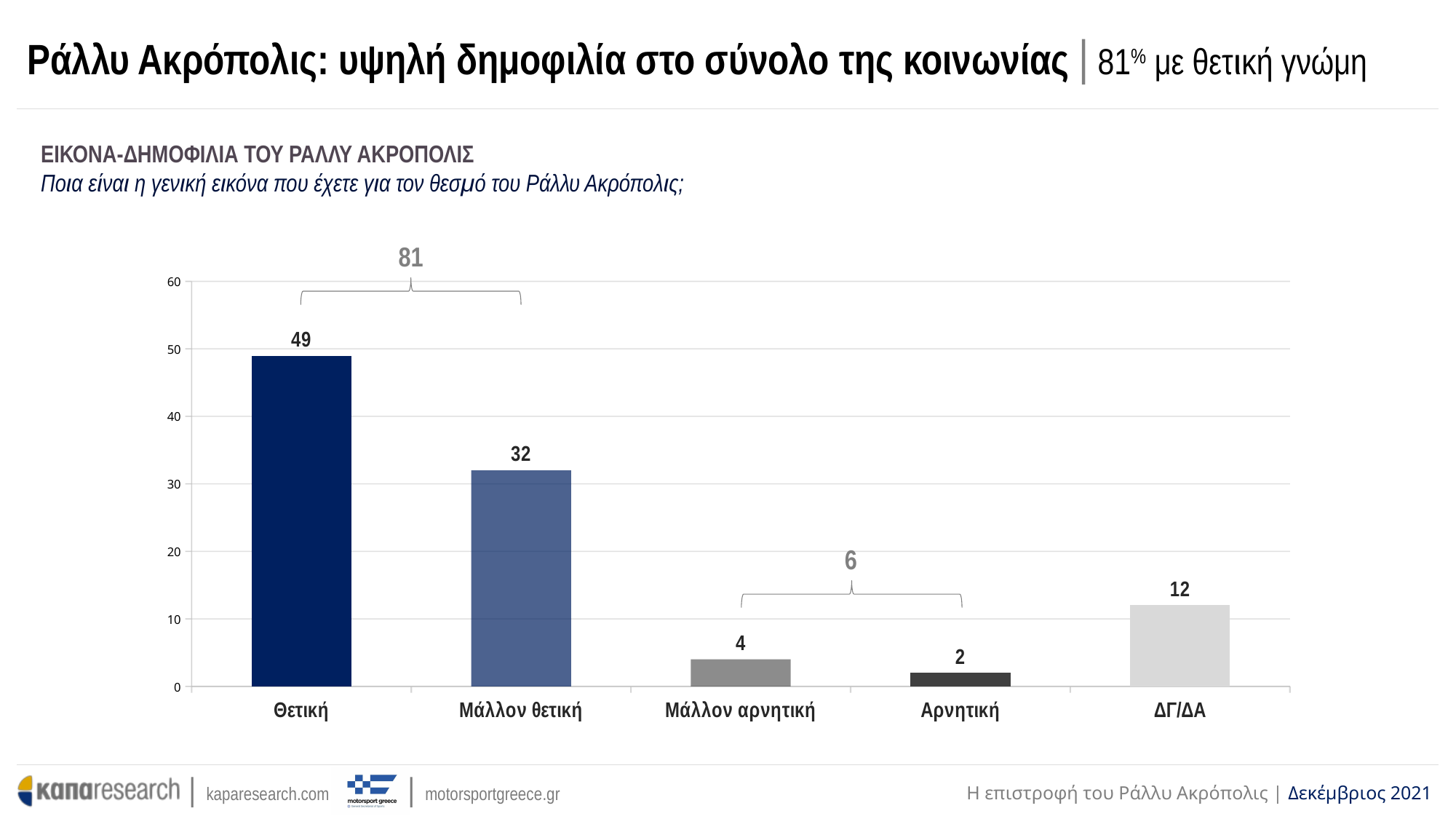
What combined value does the bracket above the Θετική and Μάλλον θετική bars show? 81 What is the difference between the values for Θετική and Μάλλον θετική? 17 What is the value for Μάλλον αρνητική? 4 What kind of chart is shown on the slide? bar chart Which is larger, the value for ΔΓ/ΔΑ or the value for Μάλλον αρνητική? ΔΓ/ΔΑ Which category has the lowest value? Αρνητική Is the value for Μάλλον θετική greater or less than 40? less What is the value for ΔΓ/ΔΑ? 12 What is the value for Θετική? 49 How many categories are shown on the x axis? 5 Which category has the highest value? Θετική What is the value for Μάλλον θετική? 32